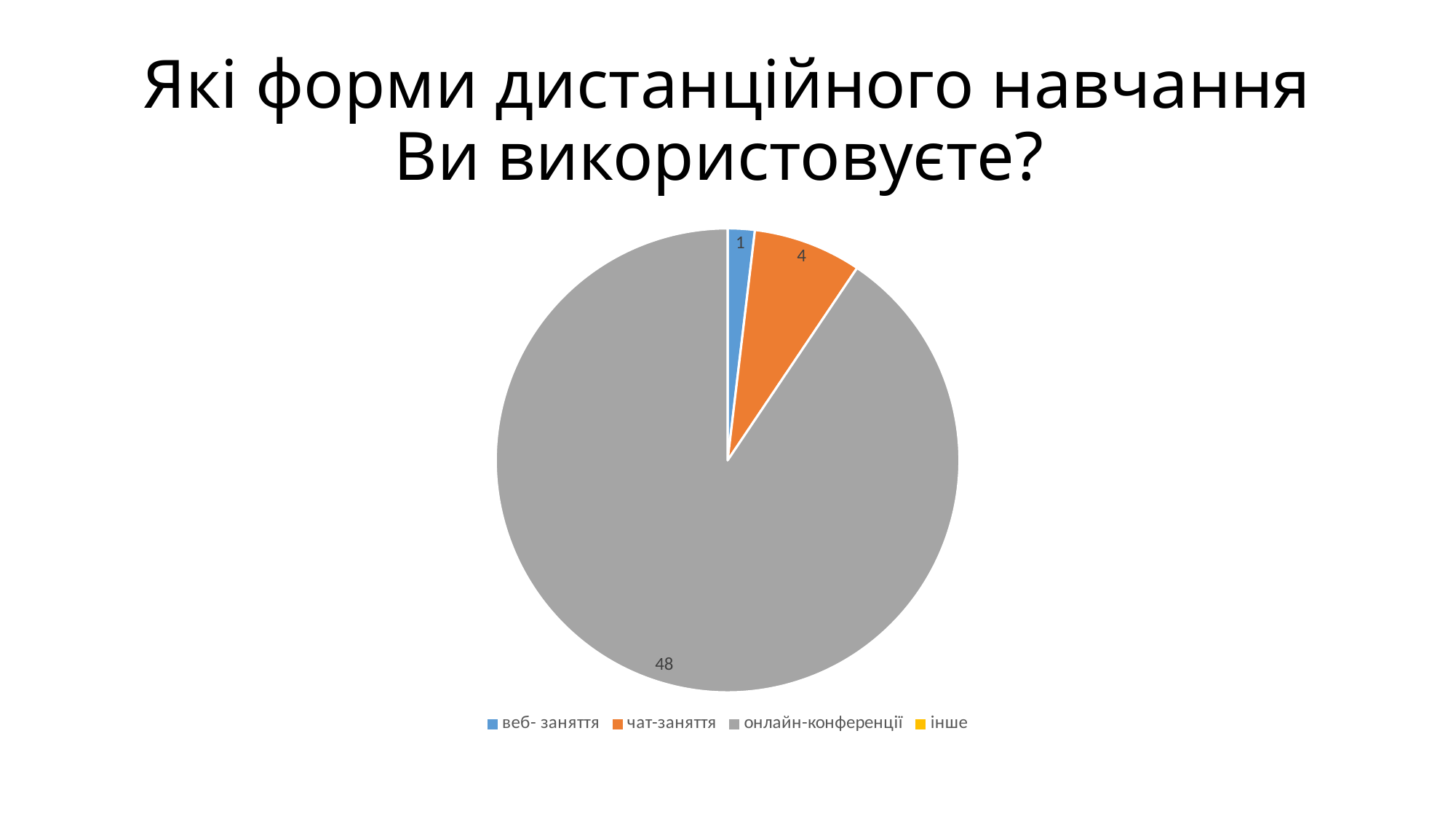
What colour is the slice for онлайн-конференції? grey Which is larger, the value for чат-заняття or the value for веб- заняття? чат-заняття What is the difference between the values for онлайн-конференції and чат-заняття? 44 What is the value for веб- заняття? 1 What is the difference between the values for чат-заняття and веб- заняття? 3 What is the title of the slide? Які форми дистанційного навчання Ви використовуєте? What kind of chart is shown on the slide? pie chart How many categories does the legend list? 4 What is the value for онлайн-конференції? 48 What is the value for чат-заняття? 4 Which category has the largest slice of the pie? онлайн-конференції Which of the labelled slices has the smallest value? веб- заняття